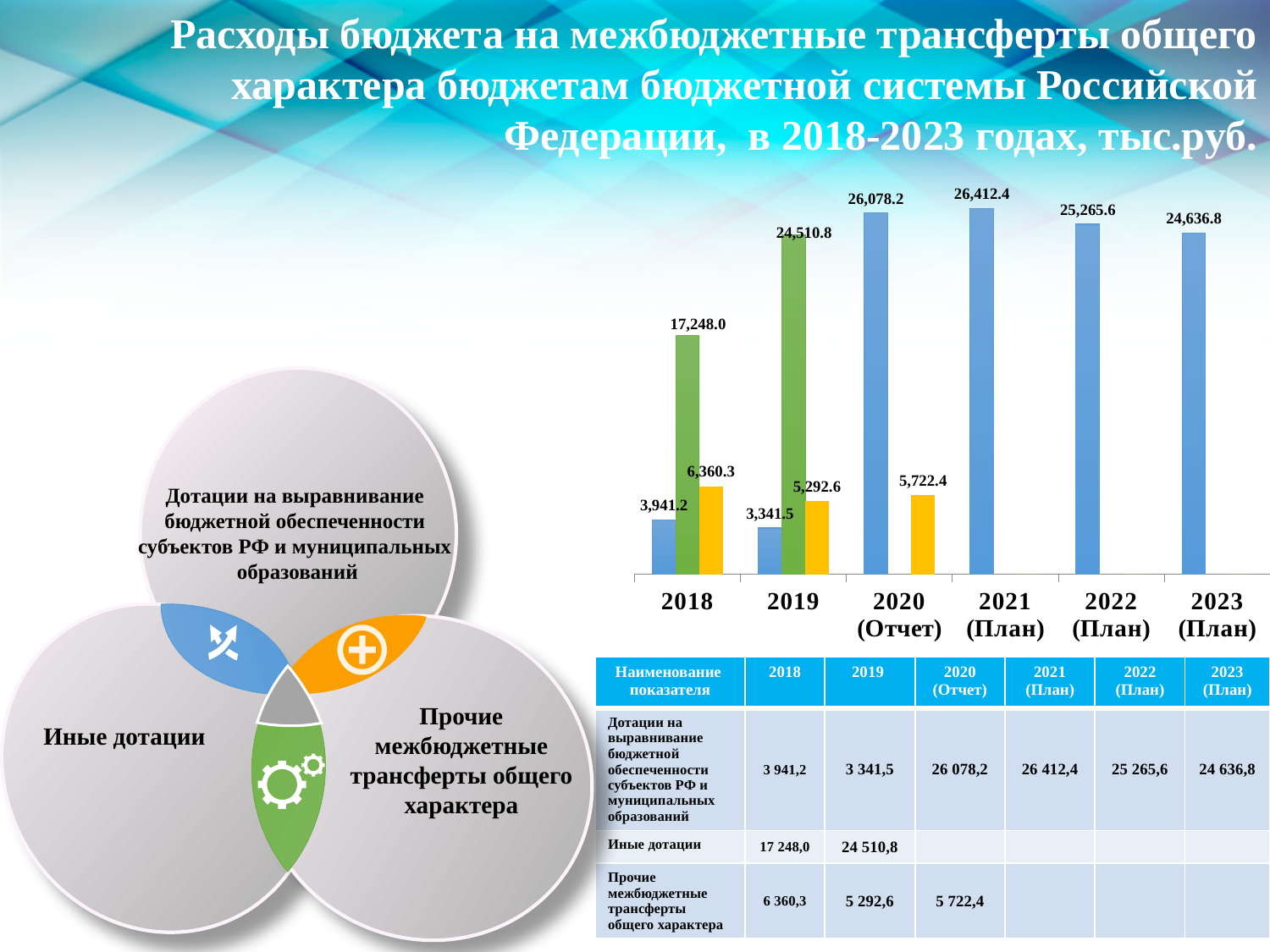
Do the Дотации на выравнивание бюджетной обеспеченности values rise or fall from 2021 (План) to 2023 (План)? Fall In which year is the Дотации на выравнивание бюджетной обеспеченности value lowest? 2019 What kind of chart is shown on the slide? Bar chart What is the value of the Иные дотации bar for 2019? 24,510.8 In which year is the Дотации на выравнивание бюджетной обеспеченности value highest? 2021 (План) What is the value of the Дотации на выравнивание бюджетной обеспеченности bar for 2021 (План)? 26,412.4 How many bars are plotted for the year 2018? 3 How many years are shown on the x axis of the chart? 6 By how much does the Дотации на выравнивание бюджетной обеспеченности value for 2021 (План) exceed the value for 2020 (Отчет)? 334.2 Which year has the larger Иные дотации value, 2018 or 2019? 2019 What is the difference between the Прочие межбюджетные трансферты общего характера values for 2018 and 2019? 1,067.7 What is the value of the Прочие межбюджетные трансферты общего характера bar for 2020 (Отчет)? 5,722.4